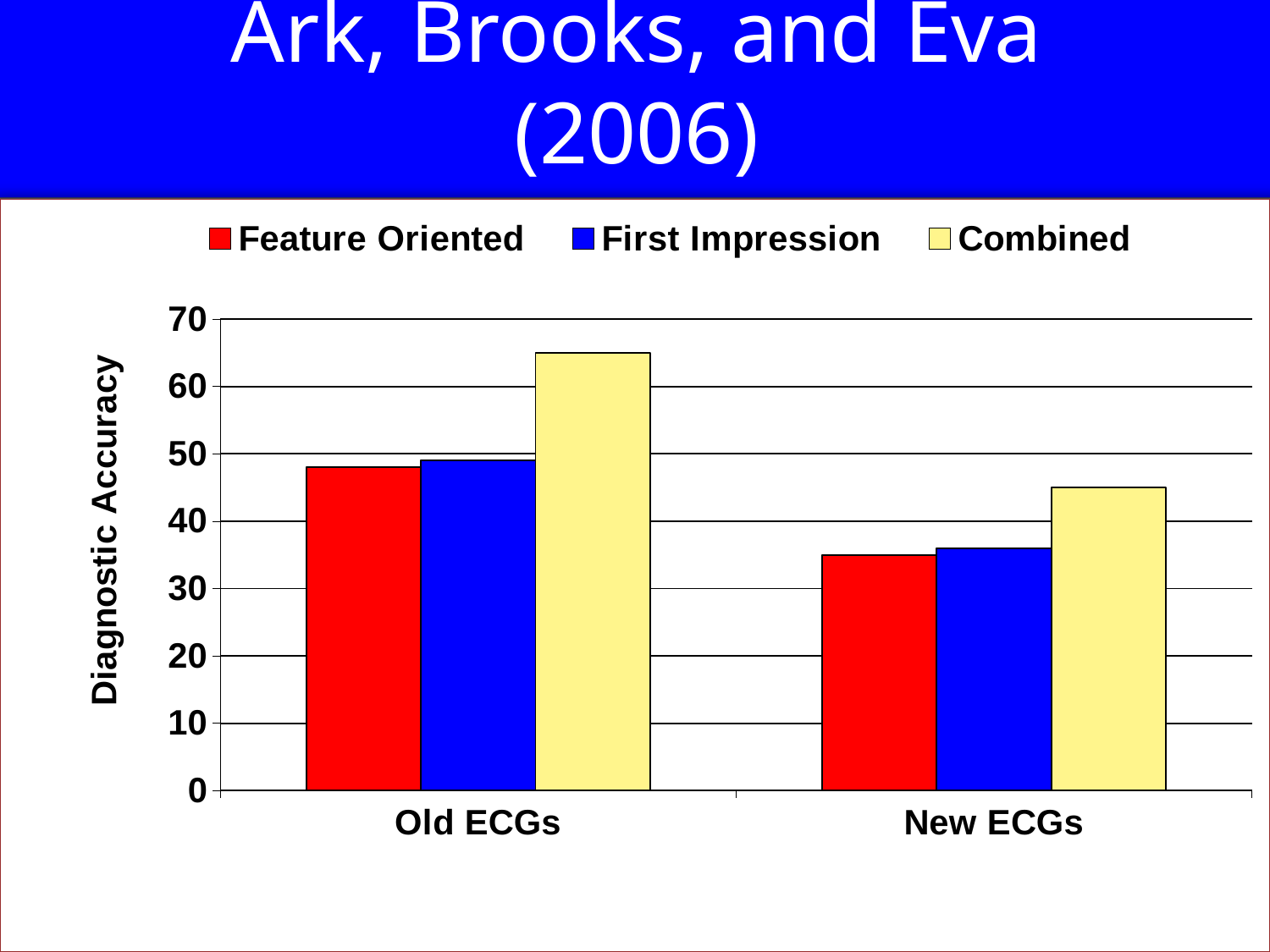
How many series does the legend list? 3 Which series has the highest diagnostic accuracy for Old ECGs? Combined Is the Feature Oriented value for Old ECGs greater or less than 50? less Which is larger for New ECGs: Feature Oriented or Combined? Combined Is the Combined value for New ECGs greater or less than 50? less Is the First Impression value for New ECGs greater or less than 40? less Which is larger: the Combined value for Old ECGs or the Combined value for New ECGs? Old ECGs How many categories are shown on the x axis? 2 Which series has the highest diagnostic accuracy for New ECGs? Combined What is the label on the vertical axis? Diagnostic Accuracy What kind of chart is shown on the slide? bar chart